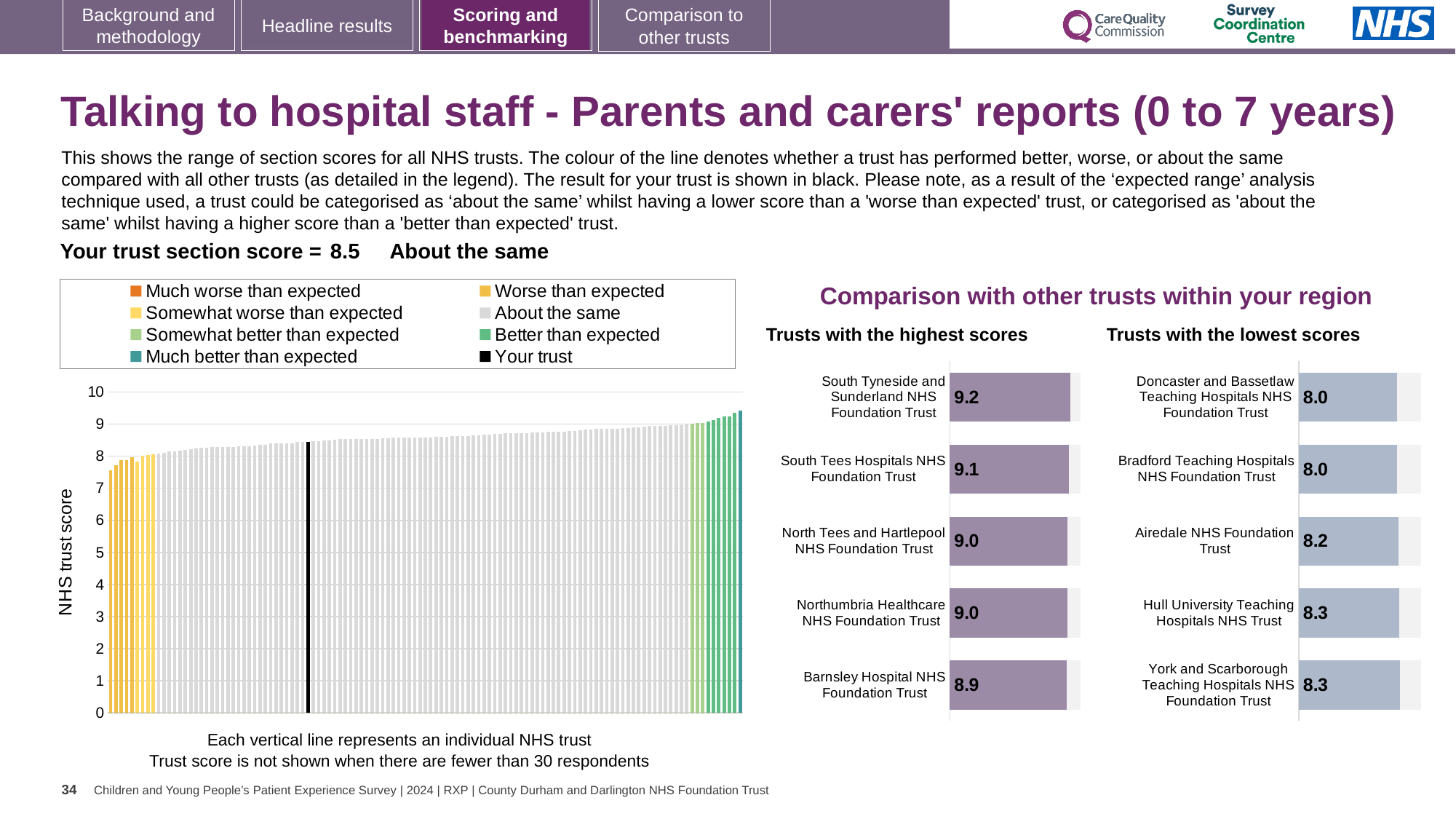
In the large chart on the left, is the value for the black bar (your trust) greater or less than 8? greater How many entries does the legend of the large chart on the left list? 8 In the 'Trusts with the lowest scores' chart, what is the difference between the scores of Hull University Teaching Hospitals NHS Trust and Doncaster and Bassetlaw Teaching Hospitals NHS Foundation Trust? 0.3 In the 'Trusts with the highest scores' chart, which trust has the lowest score? Barnsley Hospital NHS Foundation Trust In the 'Trusts with the lowest scores' chart, what is the score for Doncaster and Bassetlaw Teaching Hospitals NHS Foundation Trust? 8.0 In the 'Trusts with the highest scores' chart, what is the difference between the scores of South Tyneside and Sunderland NHS Foundation Trust and Barnsley Hospital NHS Foundation Trust? 0.3 In the 'Trusts with the lowest scores' chart, which is larger: the score for Airedale NHS Foundation Trust or Bradford Teaching Hospitals NHS Foundation Trust? Airedale NHS Foundation Trust In the 'Trusts with the highest scores' chart, how many trusts are shown? 5 In the 'Trusts with the lowest scores' chart, what is the score for Airedale NHS Foundation Trust? 8.2 What kind of chart is the large chart on the left of the slide showing NHS trust scores? Bar chart What is the y-axis label of the large chart on the left? NHS trust score In the 'Trusts with the highest scores' chart, what is the score for South Tyneside and Sunderland NHS Foundation Trust? 9.2